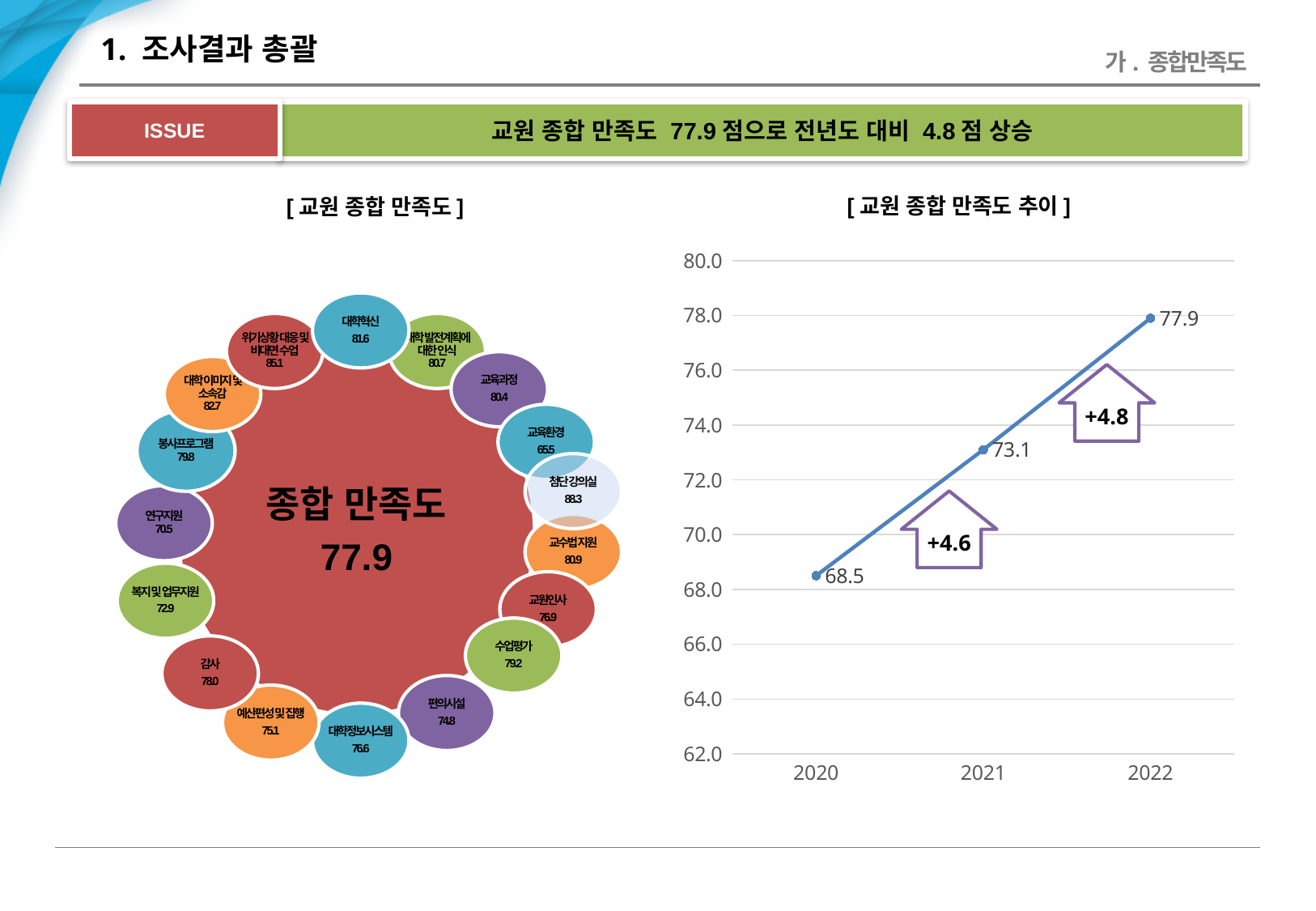
In the chart titled [ 교원 종합 만족도 추이 ], what is the difference between the 2022 and 2021 values? 4.8 In the chart titled [ 교원 종합 만족도 추이 ], which year has the lowest value? 2020 In the chart titled [ 교원 종합 만족도 추이 ], do the values rise or fall from 2020 to 2022? rise In the diagram titled [ 교원 종합 만족도 ] on the left, what is the overall 종합 만족도 value shown in the centre? 77.9 What kind of chart is the one titled [ 교원 종합 만족도 추이 ]? line chart In the chart titled [ 교원 종합 만족도 추이 ], what is the difference between the 2021 and 2020 values? 4.6 In the chart titled [ 교원 종합 만족도 추이 ], how many years are plotted? 3 In the chart titled [ 교원 종합 만족도 추이 ], what is the value for 2022? 77.9 In the chart titled [ 교원 종합 만족도 추이 ], what is the value for 2021? 73.1 In the chart titled [ 교원 종합 만족도 추이 ], which year has the highest value? 2022 In the chart titled [ 교원 종합 만족도 추이 ], what is the value for 2020? 68.5 In the diagram titled [ 교원 종합 만족도 ] on the left, what is the value for 첨단강의실? 88.3